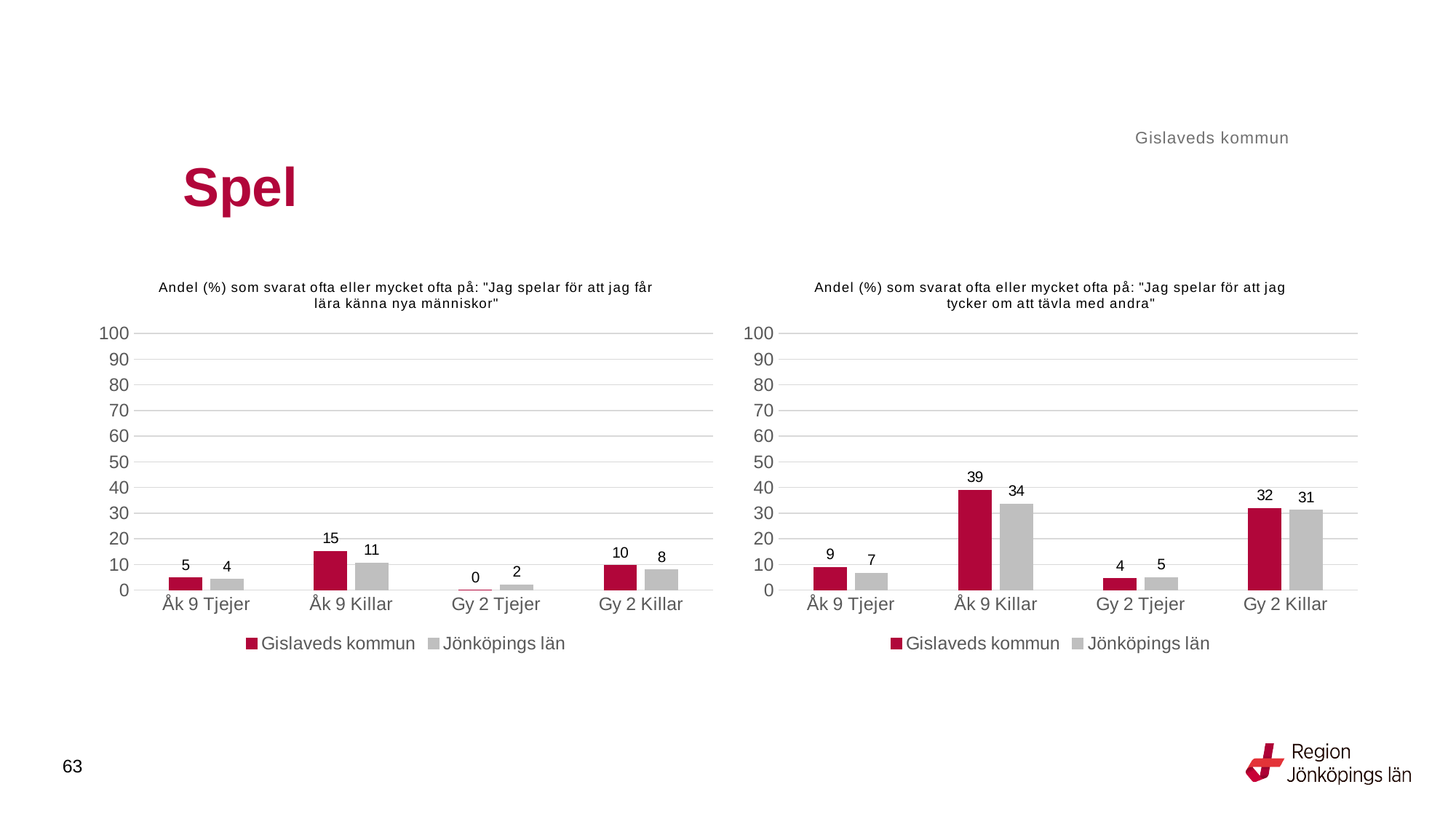
In the left chart ("Jag spelar för att jag får lära känna nya människor"), what is the value for Gislaveds kommun for Åk 9 Killar? 15 In the right chart ("Jag spelar för att jag tycker om att tävla med andra"), what is the difference between Gislaveds kommun and Jönköpings län for Åk 9 Killar? 5 In the right chart ("Jag spelar för att jag tycker om att tävla med andra"), what is the value for Gislaveds kommun for Åk 9 Killar? 39 In the right chart ("Jag spelar för att jag tycker om att tävla med andra"), which is larger for Gy 2 Tjejer: Gislaveds kommun or Jönköpings län? Jönköpings län In the left chart ("Jag spelar för att jag får lära känna nya människor"), what is the difference between Gislaveds kommun and Jönköpings län for Åk 9 Killar? 4 In the right chart ("Jag spelar för att jag tycker om att tävla med andra"), is the value for Gislaveds kommun for Gy 2 Killar greater or less than 20? greater How many series does the legend of the right chart ("Jag spelar för att jag tycker om att tävla med andra") list? 2 In the right chart ("Jag spelar för att jag tycker om att tävla med andra"), which category has the highest value for Gislaveds kommun? Åk 9 Killar How many categories are shown on the x axis of the left chart ("Jag spelar för att jag får lära känna nya människor")? 4 In the right chart ("Jag spelar för att jag tycker om att tävla med andra"), what is the value for Jönköpings län for Gy 2 Killar? 31 In the left chart ("Jag spelar för att jag får lära känna nya människor"), which category has the lowest value for Gislaveds kommun? Gy 2 Tjejer In the left chart ("Jag spelar för att jag får lära känna nya människor"), what is the value for Jönköpings län for Gy 2 Tjejer? 2